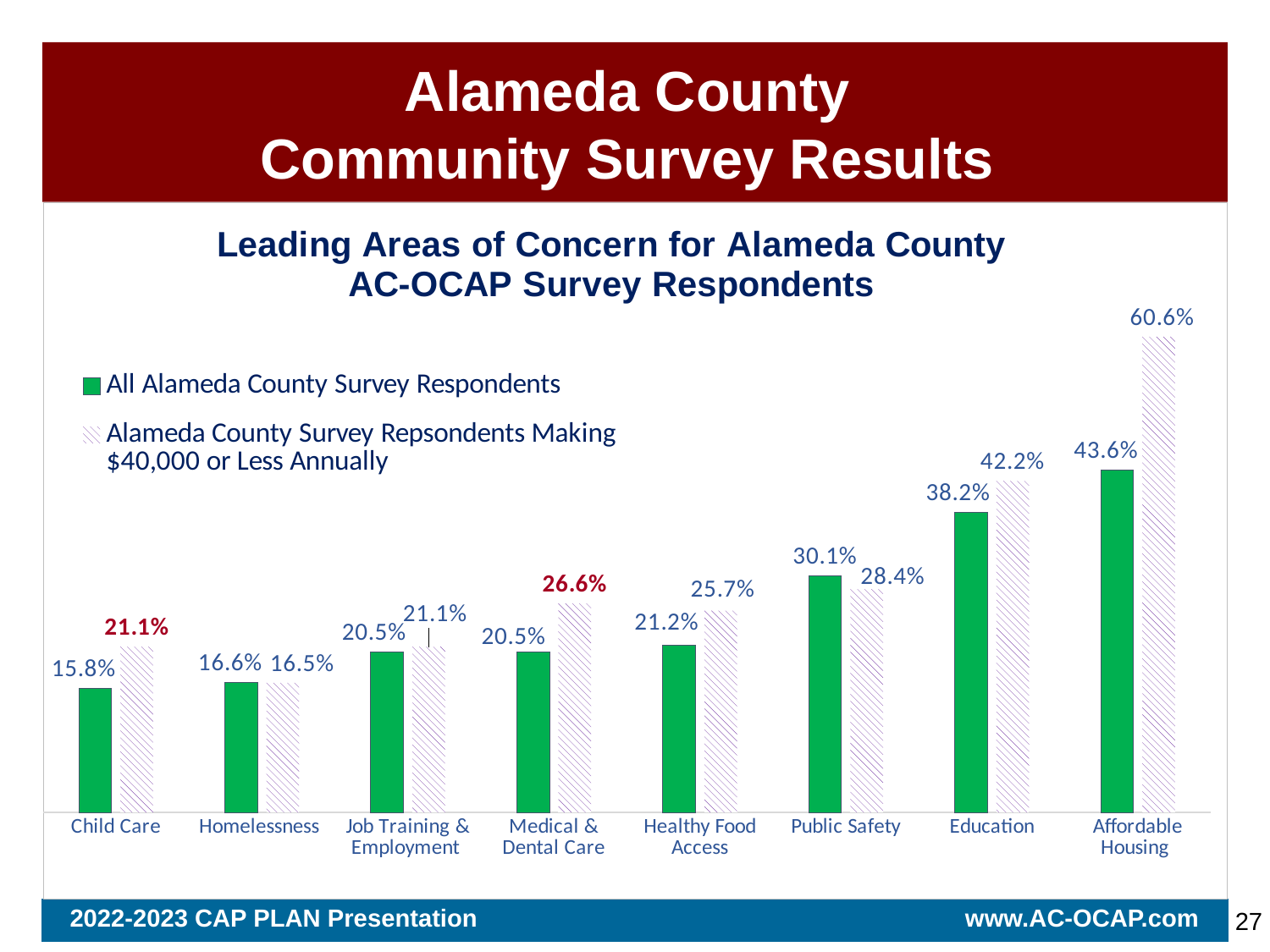
What percentage of All Alameda County Survey Respondents cited Affordable Housing as a concern? 43.6% What is the difference between the Medical & Dental Care values for the two series? 6.1% How many areas of concern are shown along the x axis? 8 What is the title of the chart? Leading Areas of Concern for Alameda County AC-OCAP Survey Respondents Which area of concern has the highest value for Alameda County Survey Respondents Making $40,000 or Less Annually? Affordable Housing What is the difference between the two series' values for Affordable Housing? 17.0% What is the value for Child Care among All Alameda County Survey Respondents? 15.8% What kind of chart is shown on the slide? Bar chart How many series does the legend list? 2 For Public Safety, which series has the larger value: All Alameda County Survey Respondents or Alameda County Survey Respondents Making $40,000 or Less Annually? All Alameda County Survey Respondents Which area of concern has the lowest value for All Alameda County Survey Respondents? Child Care What is the value for Education among Alameda County Survey Respondents Making $40,000 or Less Annually? 42.2%